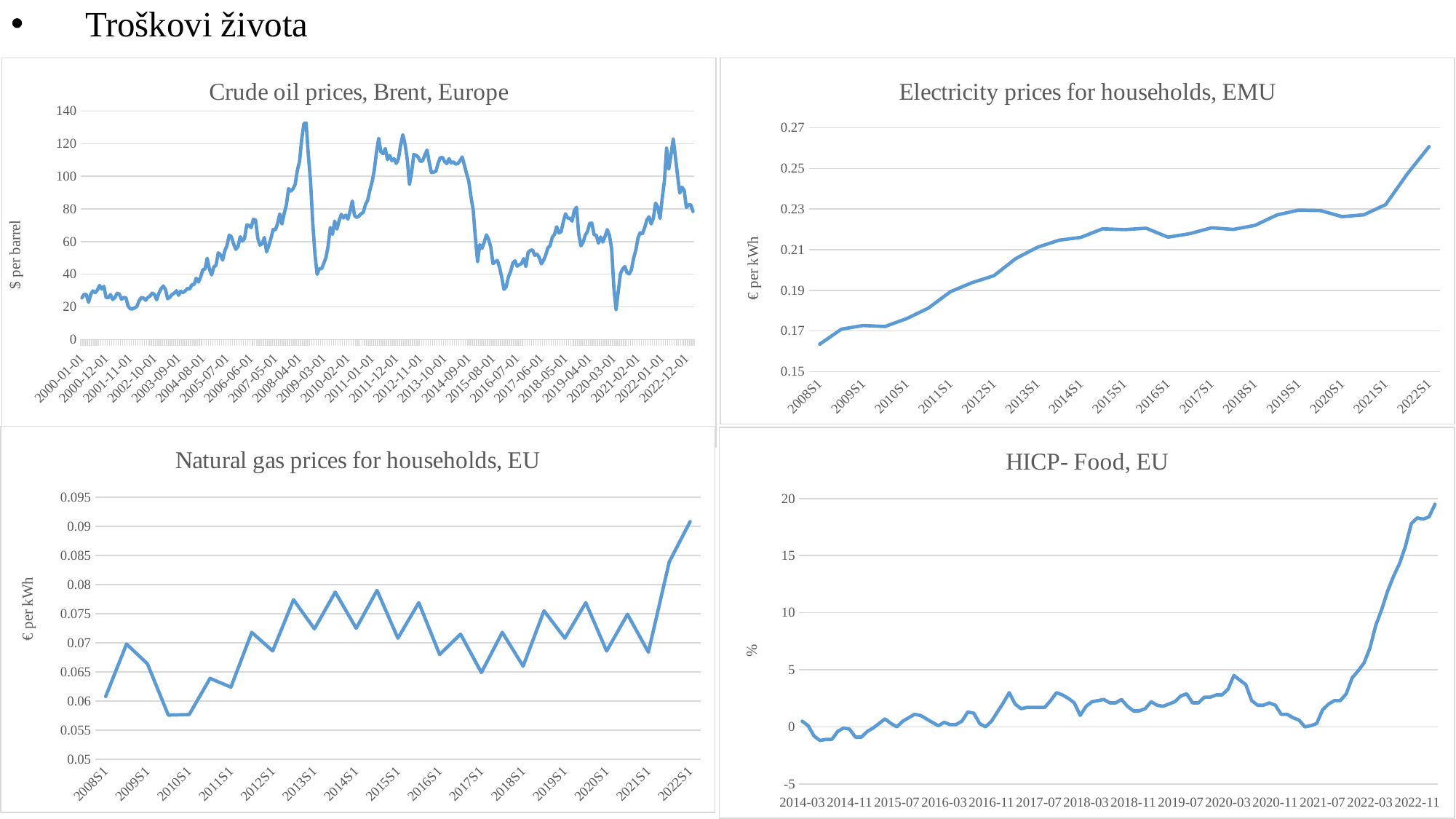
What kind of chart is 'Crude oil prices, Brent, Europe'? line chart In the 'Electricity prices for households, EMU' chart, is the value for 2022S1 greater or less than 0.25? greater In the 'Electricity prices for households, EMU' chart, is the value for 2008S1 greater or less than 0.17? less What is the y-axis label of the 'Electricity prices for households, EMU' chart? € per kWh In the 'Crude oil prices, Brent, Europe' chart, is the highest value on the line greater or less than 120? greater In the 'Electricity prices for households, EMU' chart, do values overall rise or fall from 2008S1 to 2022S1? rise In the 'Electricity prices for households, EMU' chart, which is larger, the value for 2008S1 or the value for 2022S1? 2022S1 What is the y-axis label of the 'Crude oil prices, Brent, Europe' chart? $ per barrel In the 'HICP- Food, EU' chart, do values rise or fall between 2021-07 and 2022-11? rise